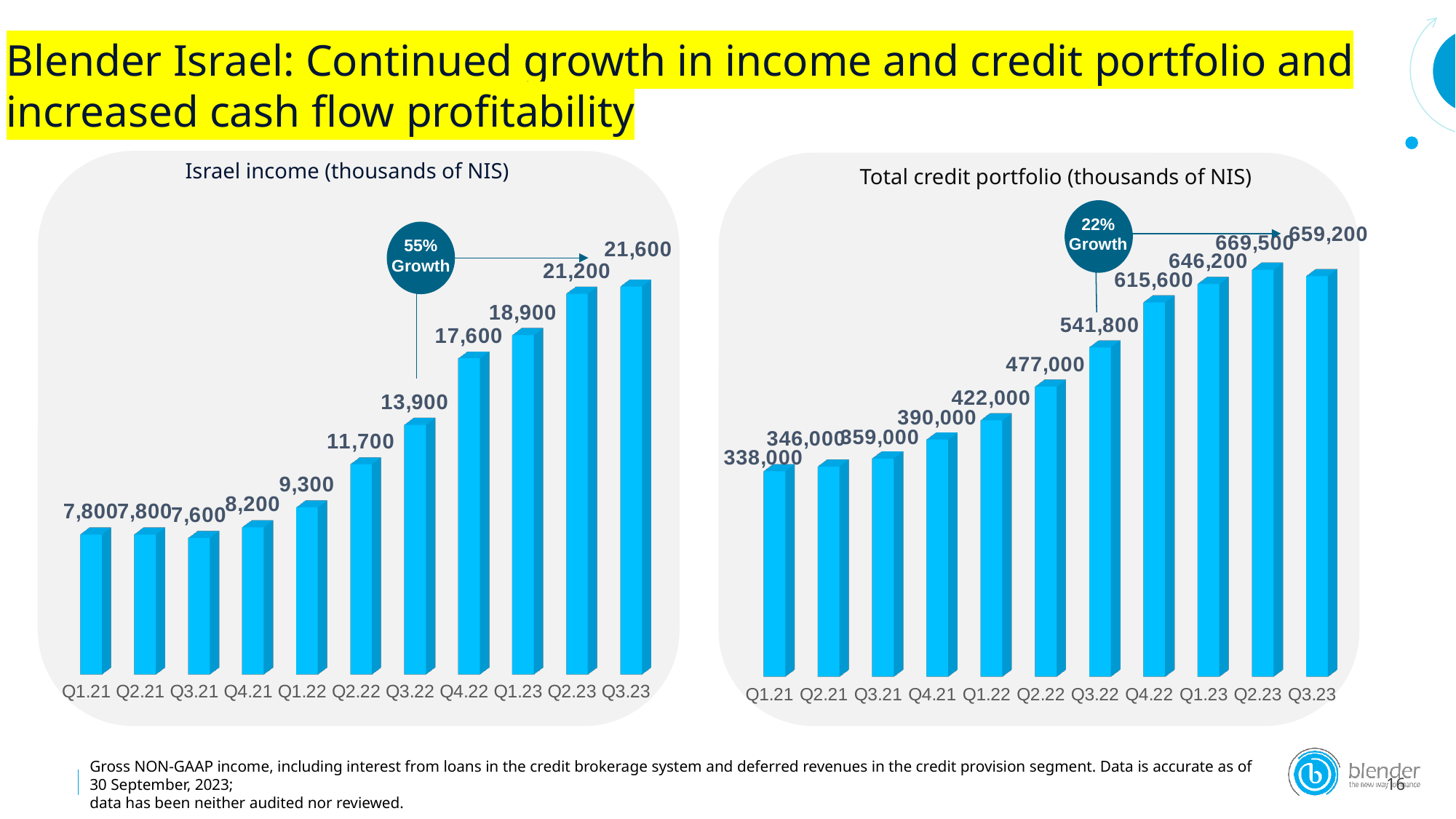
In the 'Total credit portfolio (thousands of NIS)' chart, what is the value for Q1.21? 338,000 In the 'Israel income (thousands of NIS)' chart, which quarter has the lowest value? Q3.21 In the 'Total credit portfolio (thousands of NIS)' chart, which is larger, Q2.23 or Q3.23? Q2.23 In the 'Israel income (thousands of NIS)' chart, how many quarters are shown on the x axis? 11 In the 'Total credit portfolio (thousands of NIS)' chart, what is the value for Q2.23? 669,500 In the 'Total credit portfolio (thousands of NIS)' chart, what is the difference between Q3.22 and Q2.22? 64,800 In the 'Israel income (thousands of NIS)' chart, what is the value for Q3.22? 13,900 In the 'Total credit portfolio (thousands of NIS)' chart, which quarter has the highest value? Q2.23 In the 'Israel income (thousands of NIS)' chart, what is the difference between Q3.23 and Q3.22? 7,700 In the 'Israel income (thousands of NIS)' chart, what growth percentage is shown in the circle annotation? 55% Growth What type of chart is the 'Total credit portfolio (thousands of NIS)' chart? Bar chart In the 'Israel income (thousands of NIS)' chart, what is the value for Q3.23? 21,600